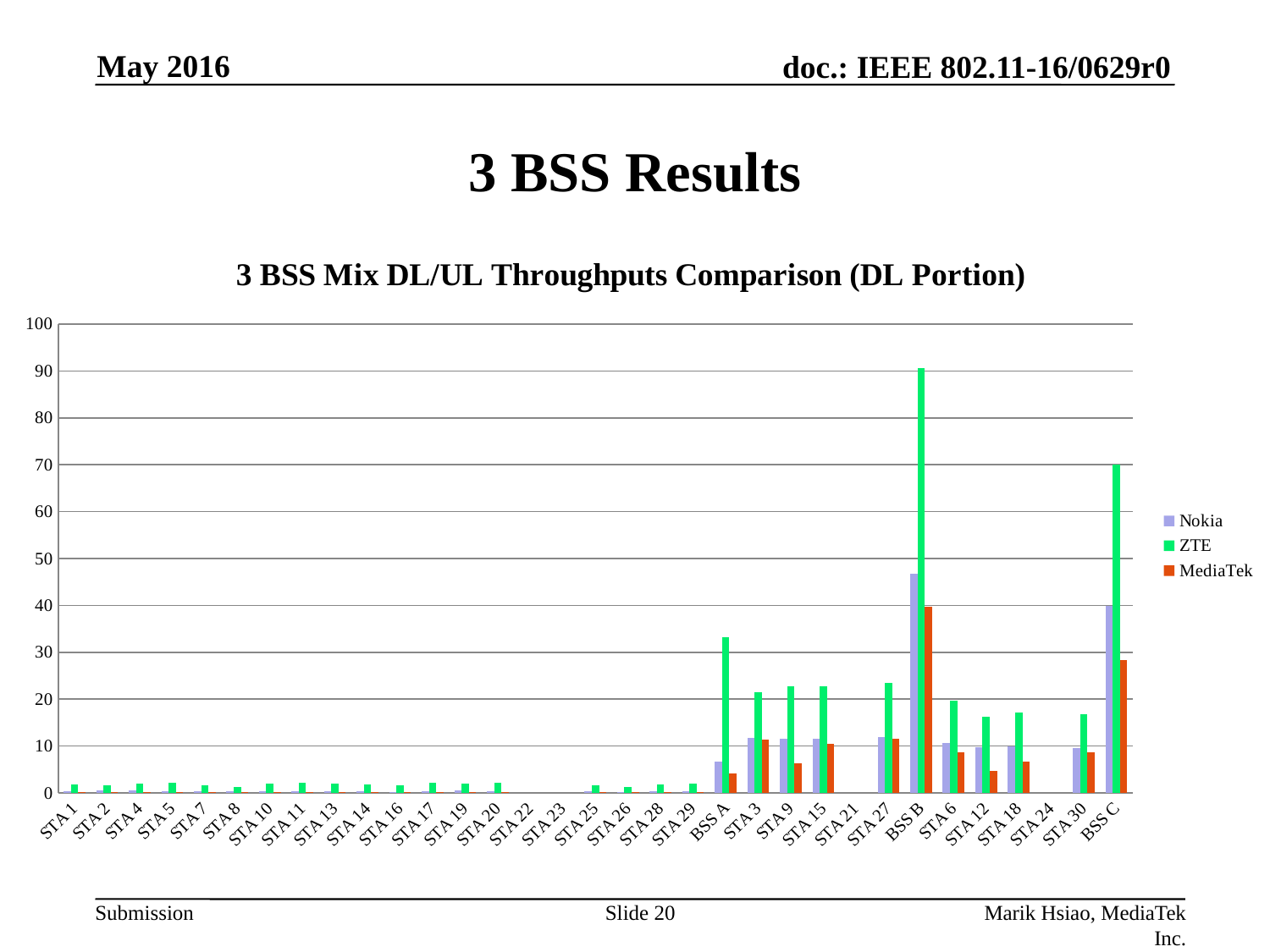
Is the ZTE value for BSS C greater or less than 60? greater For BSS A, which is larger, the ZTE value or the Nokia value? ZTE Which category has the highest ZTE value? BSS B Is the ZTE value for BSS B greater or less than 80? greater What kind of chart is shown on the slide? bar chart How many series does the legend list? 3 Is the MediaTek value for BSS C greater or less than 20? greater Which category has the highest Nokia value? BSS B For BSS B, which is larger, the ZTE value or the MediaTek value? ZTE Which series is shown in green in the legend? ZTE What is the title of the chart? 3 BSS Mix DL/UL Throughputs Comparison (DL Portion)